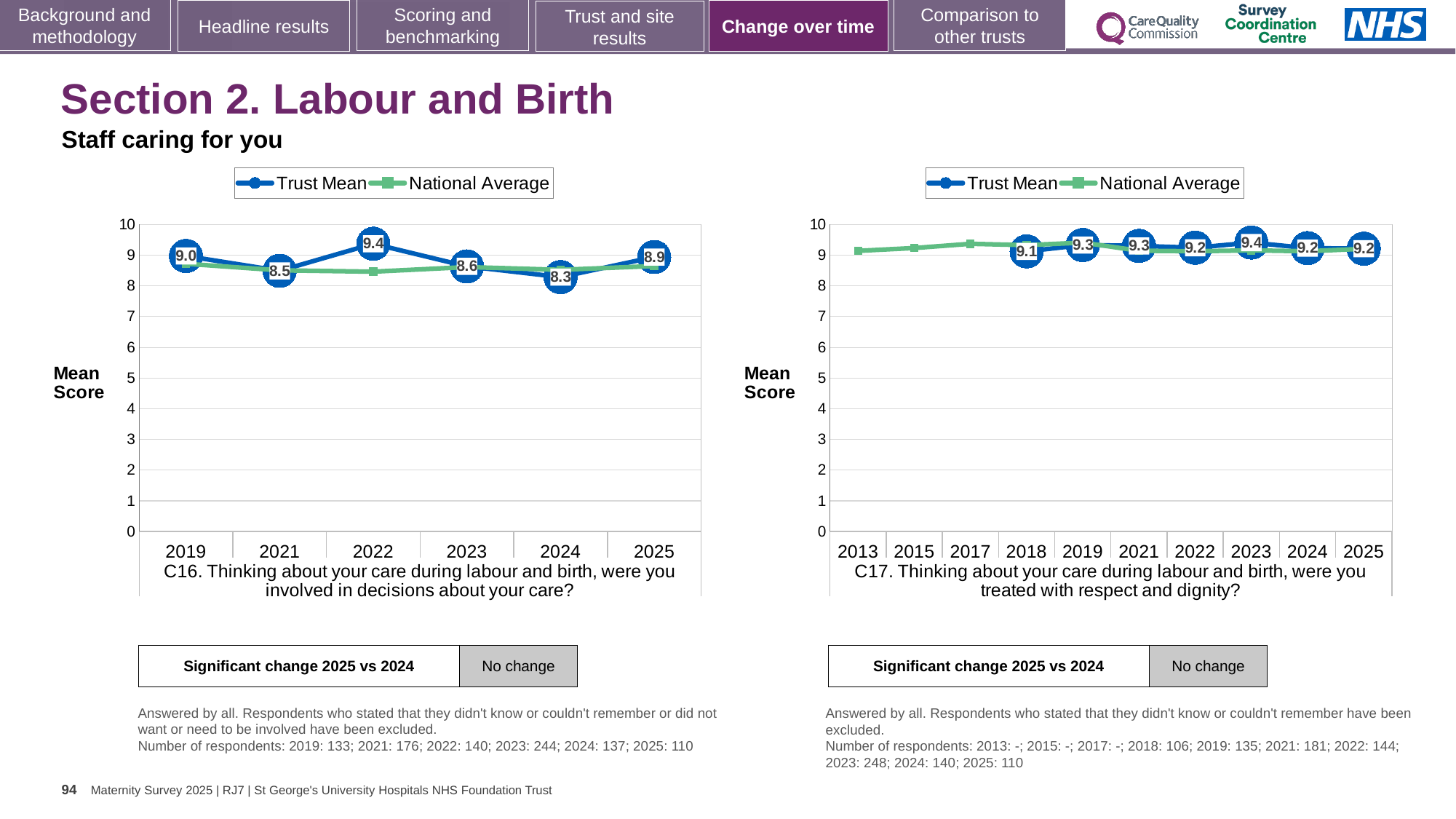
In the C16 chart (left), what is the difference between the Trust Mean for 2022 and 2024? 1.1 In the C17 chart (right), what is the Trust Mean for 2023? 9.4 How many series does the legend of the C17 chart (right) list? 2 What kind of chart is the C16 chart (left)? Line chart In the C16 chart (left), how many years are shown on the x axis? 6 In the C17 chart (right), is the Trust Mean for 2025 greater or less than 8? greater In the C16 chart (left), which year has the lowest Trust Mean? 2024 In the C16 chart (left), which year has the highest Trust Mean? 2022 In the C17 chart (right), what is the Trust Mean for 2018? 9.1 In the C16 chart (left), what is the Trust Mean for 2022? 9.4 In the C16 chart (left), what is the Trust Mean for 2024? 8.3 In the C17 chart (right), which year has the highest Trust Mean? 2023